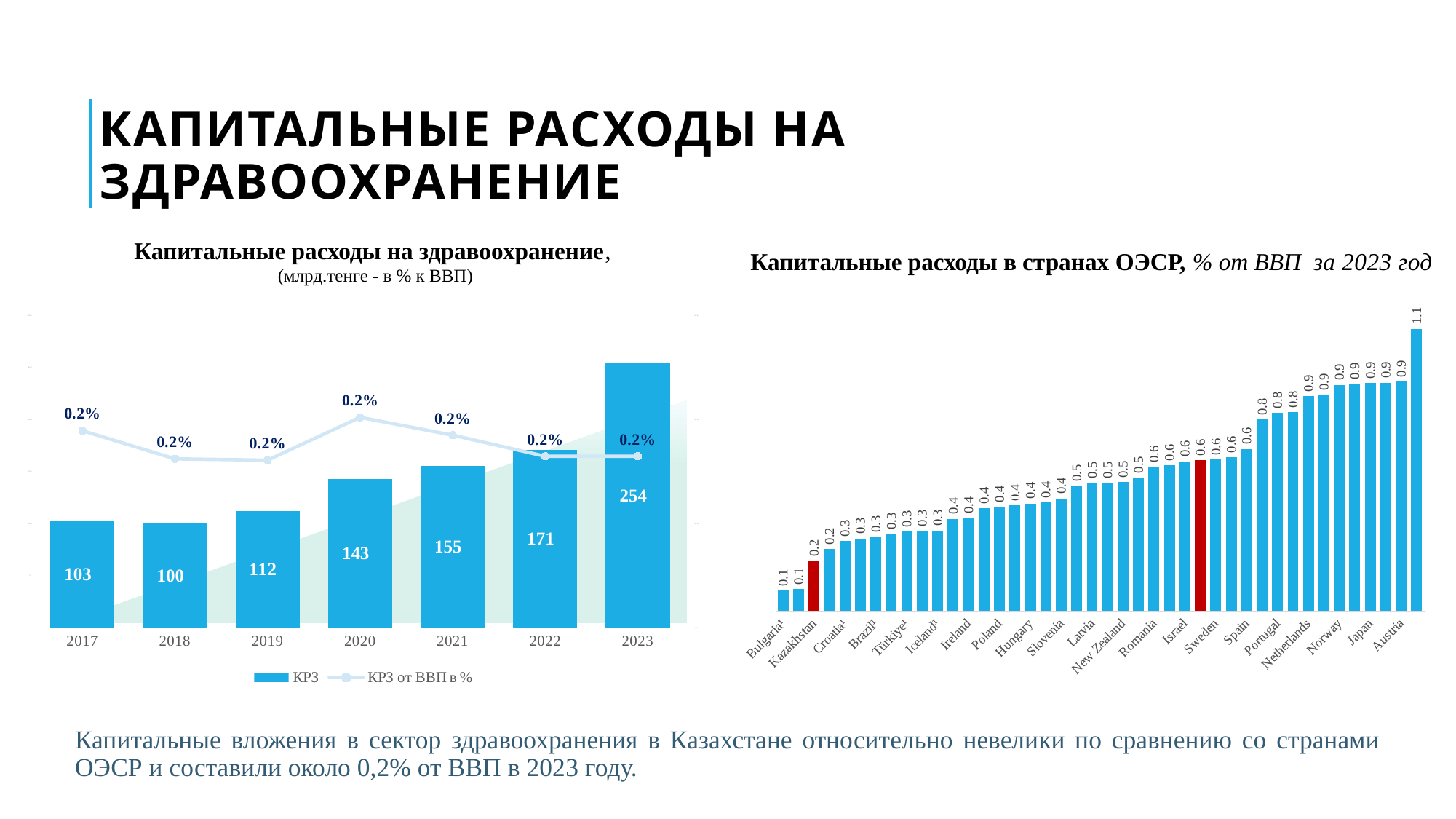
On the left chart 'Капитальные расходы на здравоохранение', what is the difference between the bar values for 2023 and 2022? 83 On the left chart 'Капитальные расходы на здравоохранение', how many series does the legend list? 2 On the left chart 'Капитальные расходы на здравоохранение', what is the value of the bar for 2023? 254 On the left chart 'Капитальные расходы на здравоохранение', what is the value of the bar for 2017? 103 On the right chart 'Капитальные расходы в странах ОЭСР', what is the value for Kazakhstan? 0.2 On the left chart 'Капитальные расходы на здравоохранение', which year has the lowest bar? 2018 On the left chart 'Капитальные расходы на здравоохранение', how many years are shown on the x axis? 7 On the left chart 'Капитальные расходы на здравоохранение', do the bar values generally rise or fall from 2017 to 2023? rise On the left chart 'Капитальные расходы на здравоохранение', what is the value of the line 'КРЗ от ВВП в %' for 2020? 0.2% On the right chart 'Капитальные расходы в странах ОЭСР', what is the value for Austria? 0.9